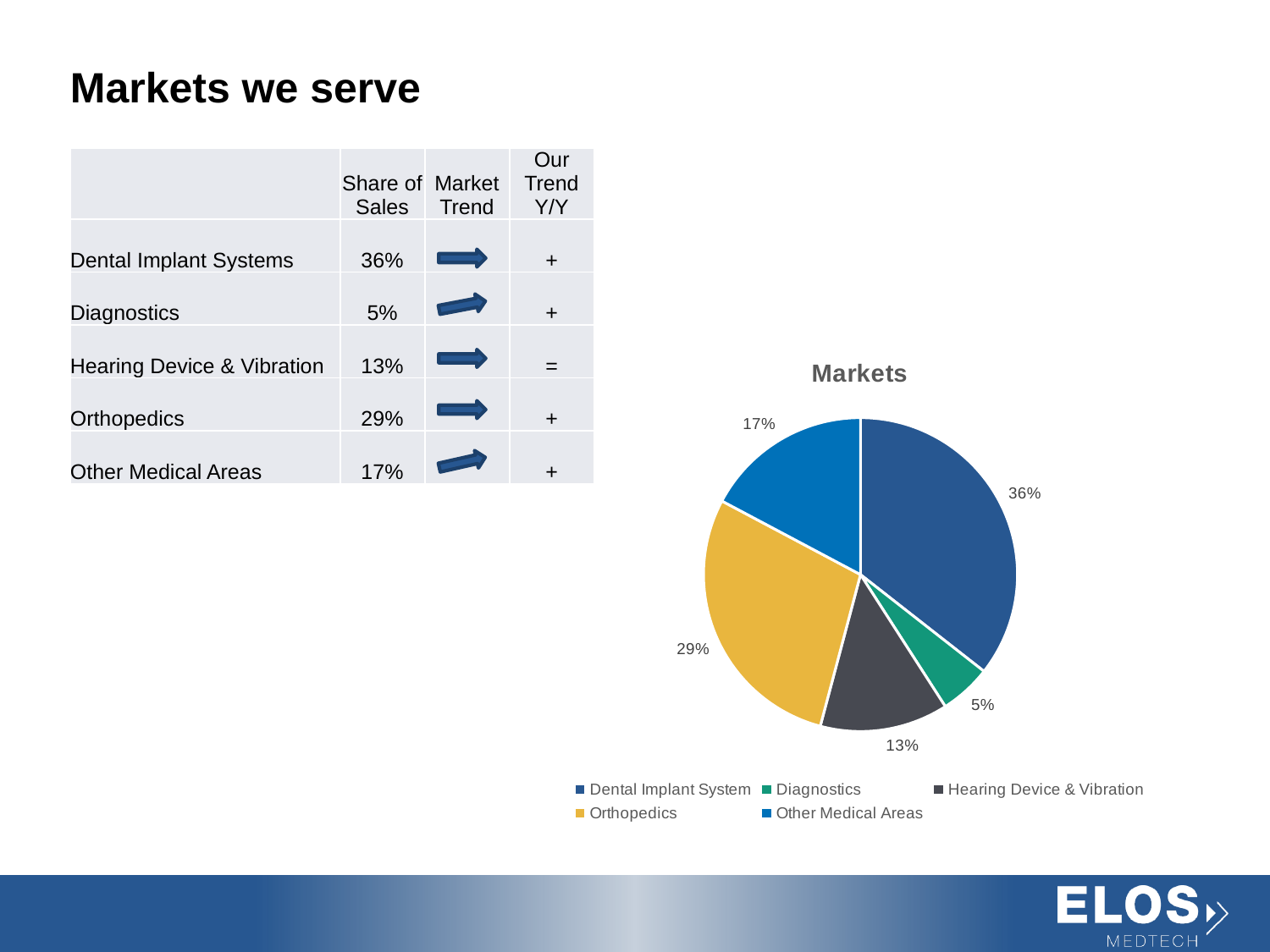
Which category has the largest slice of the pie? Dental Implant System What is the value shown for Other Medical Areas in the pie chart? 17% What is the value shown for Hearing Device & Vibration in the pie chart? 13% What type of chart is shown on the slide? pie chart How many categories does the legend list? 5 What is the difference between the Dental Implant System and Orthopedics shares? 7% What is the title of the chart? Markets Which category has the smallest slice of the pie? Diagnostics What is the value shown for Diagnostics in the pie chart? 5% Which is larger, the Other Medical Areas slice or the Hearing Device & Vibration slice? Other Medical Areas What share of the pie does Dental Implant System hold? 36% What is the value shown for Orthopedics in the pie chart? 29%